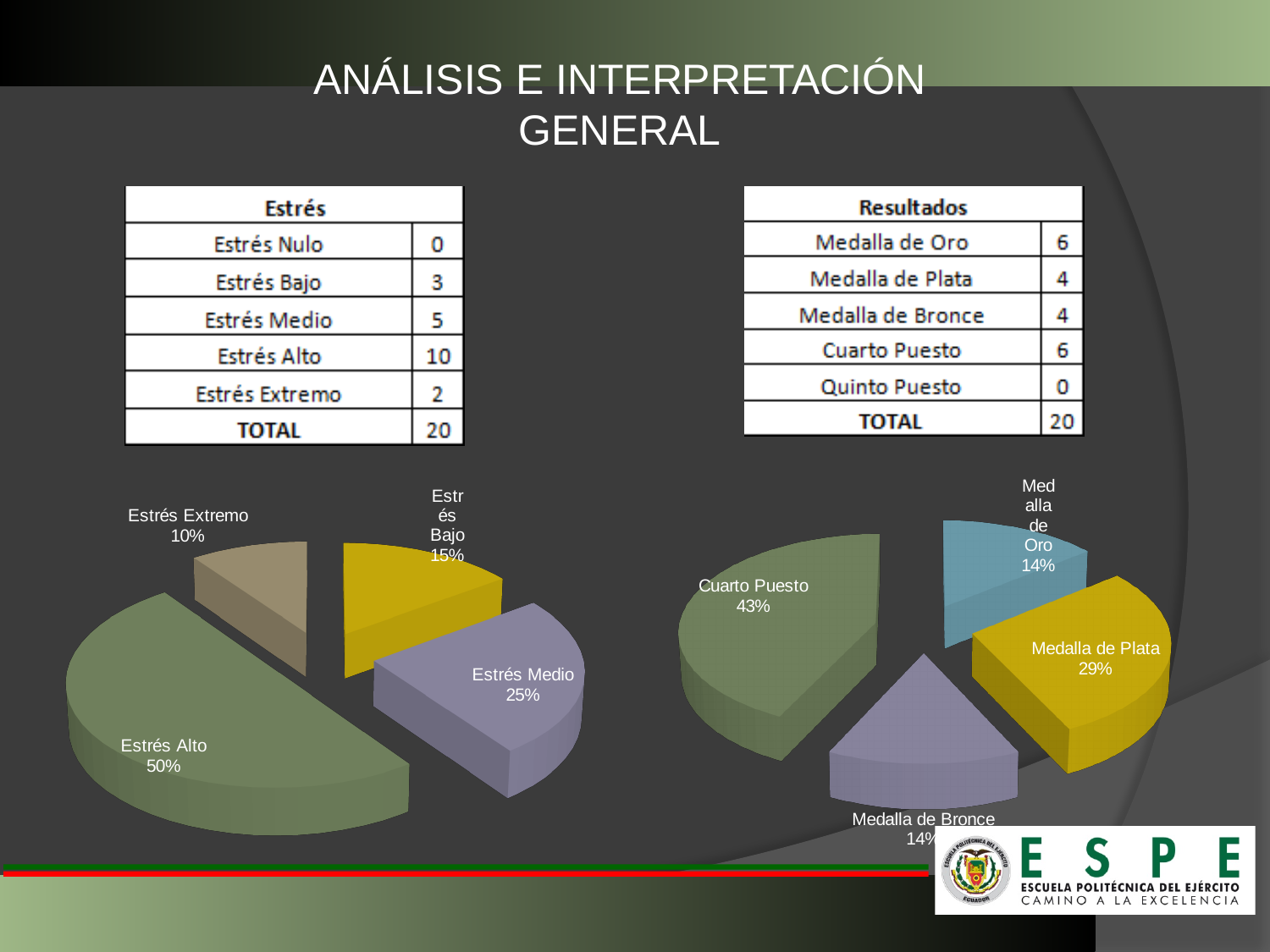
In the left pie chart, how many slices are shown? 4 In the left pie chart, which category has the largest slice? Estrés Alto In the left pie chart, which category has the smallest slice? Estrés Extremo In the right pie chart, what is the difference in percentage points between Cuarto Puesto and Medalla de Plata? 14 In the right pie chart, which category has the largest slice? Cuarto Puesto In the left pie chart, what share is labelled for Estrés Medio? 25% In the right pie chart, what share is labelled for Cuarto Puesto? 43% In the left pie chart, what is the difference in percentage points between Estrés Alto and Estrés Medio? 25 What type of chart is used on the left side of the slide? Pie chart In the left pie chart, what share is labelled for Estrés Alto? 50% In the right pie chart, which is larger, Medalla de Plata or Medalla de Oro? Medalla de Plata In the right pie chart, what share is labelled for Medalla de Plata? 29%